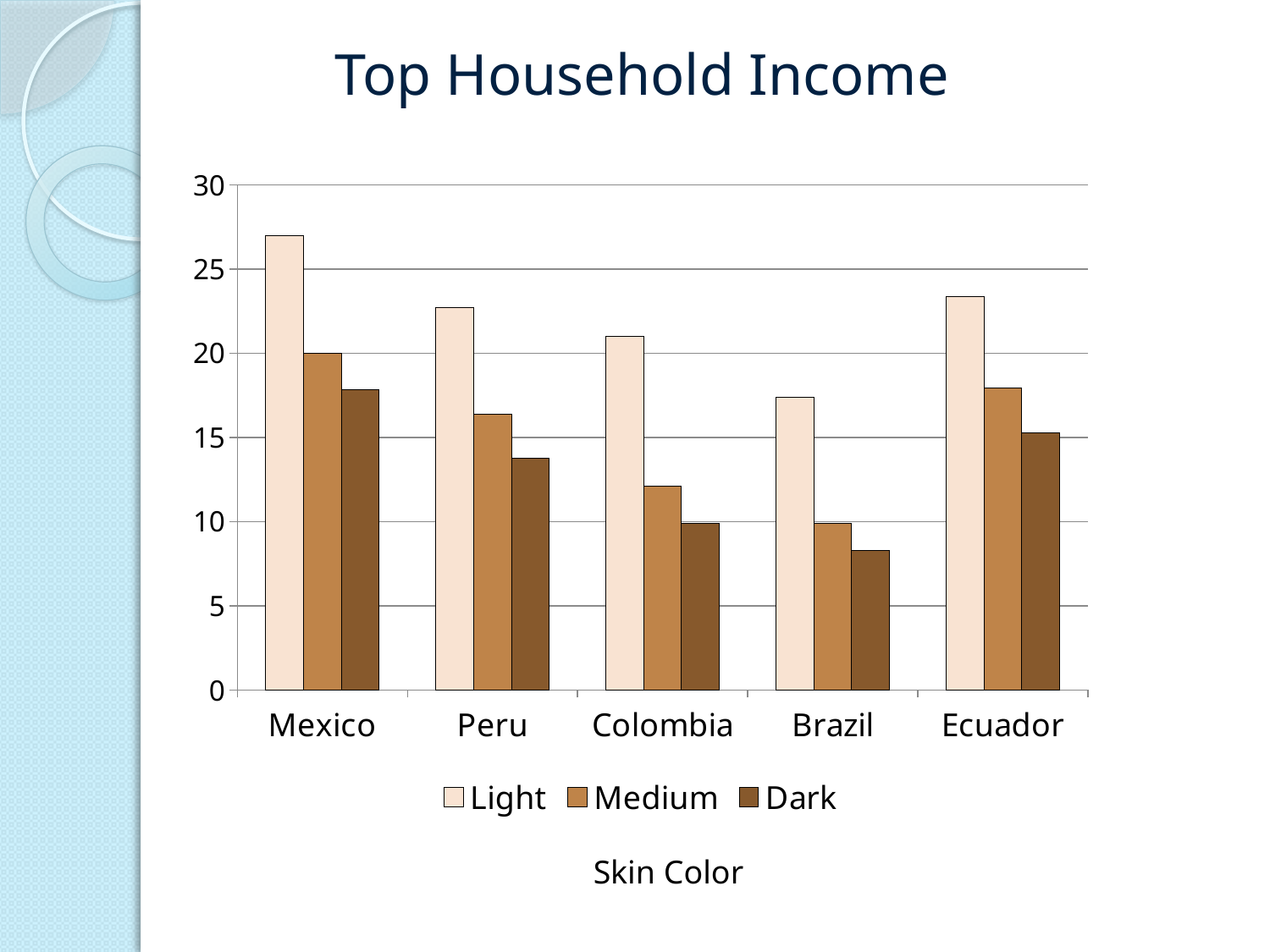
What is the title of the chart? Top Household Income Is the value for Medium in Peru greater or less than 15? greater Which is larger: the Medium value for Colombia or the Dark value for Peru? Dark value for Peru What kind of chart is shown on the slide? bar chart Which country has the lowest value for the Dark series? Brazil How many series does the legend list? 3 Which country has the highest value for the Light series? Mexico Is the value for Light in Mexico greater or less than 25? greater Which is larger: the Light value for Ecuador or the Light value for Peru? Ecuador How many countries are shown on the x axis? 5 Which country has the lowest value for the Light series? Brazil Is the value for Dark in Brazil greater or less than 10? less